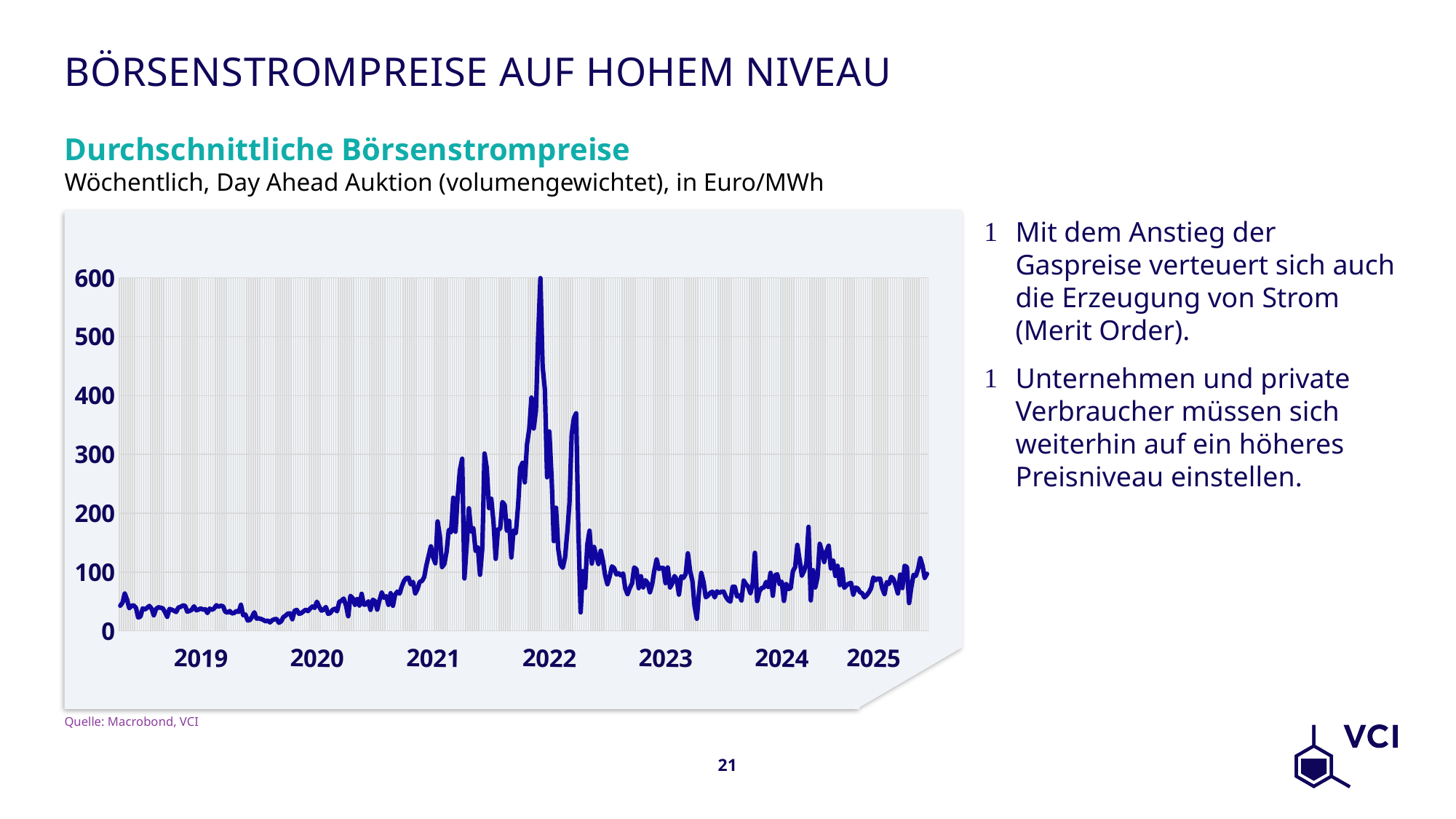
Are the values in 2025 greater or less than 200? less Do the values rise or fall from 2019 to the peak in 2022? rise Is the value in 2023 higher or lower than the peak value in 2022? lower Is the highest peak of the line greater or less than 500? greater How many year labels are shown on the x axis? 7 In which year labelled on the x axis does the line reach its highest peak? 2022 Are the values in 2020 greater or less than 100? less What kind of chart is shown on the slide? line chart What source is given for the chart? Macrobond, VCI Do the values rise or fall from the 2022 peak to 2023? fall What is the title of the chart? Durchschnittliche Börsenstrompreise